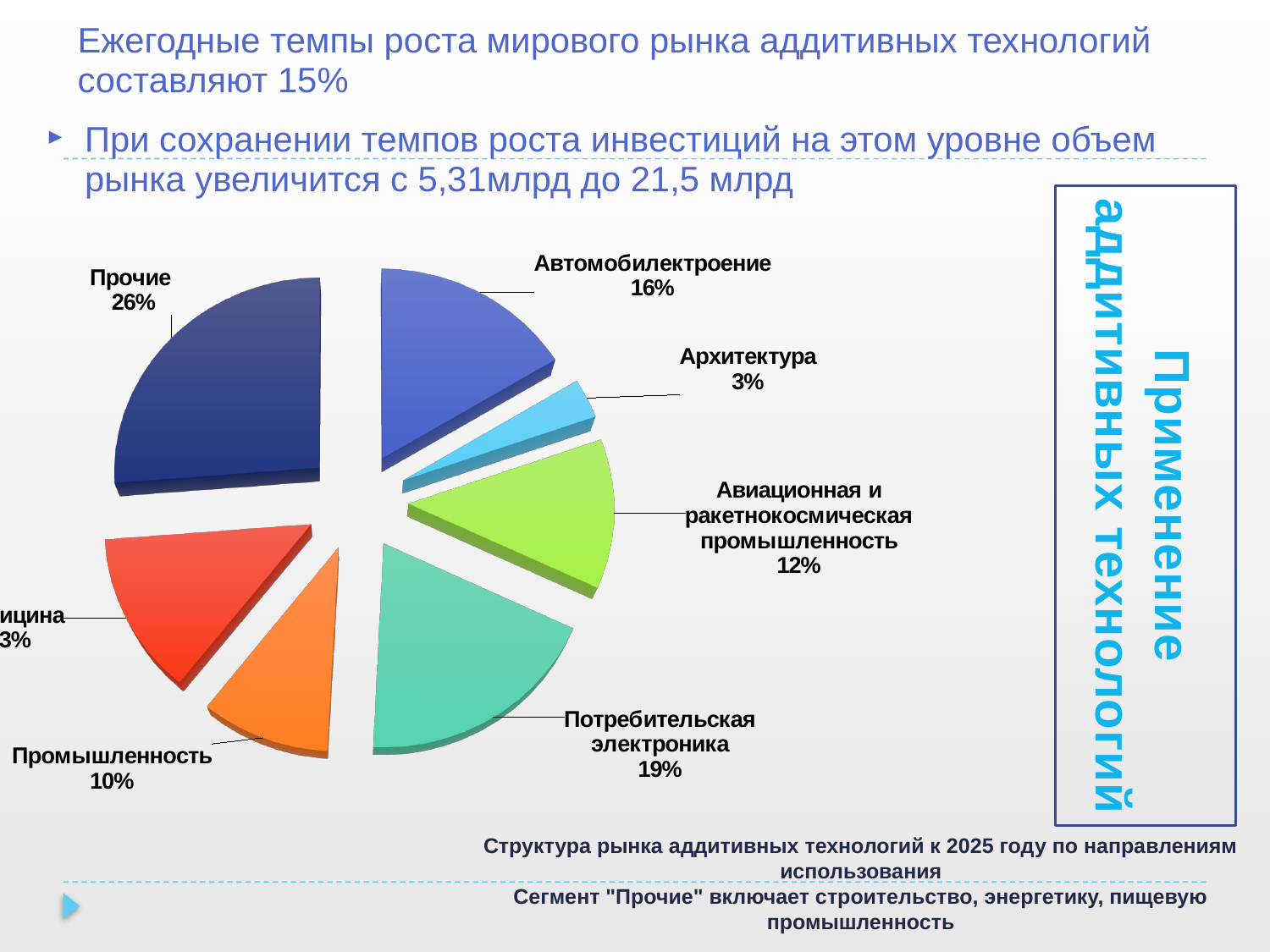
What kind of chart is shown on the slide? pie chart What is the value shown for "Промышленность"? 10% What is the difference between the shares of "Прочие" and "Потребительская электроника"? 7% What is the value shown for "Авиационная и ракетнокосмическая промышленность"? 12% Which segment has the largest share of the pie? Прочие According to the caption, what does the "Прочие" segment include? строительство, энергетику, пищевую промышленность What share of the market does the "Прочие" segment hold? 26% Which segment has the smallest share of the pie? Архитектура What is the value shown for "Потребительская электроника"? 19% Which is larger: the share of "Автомобилектроение" or the share of "Авиационная и ракетнокосмическая промышленность"? Автомобилектроение What is the value shown for "Автомобилектроение"? 16% How many slices does the pie chart have? 7